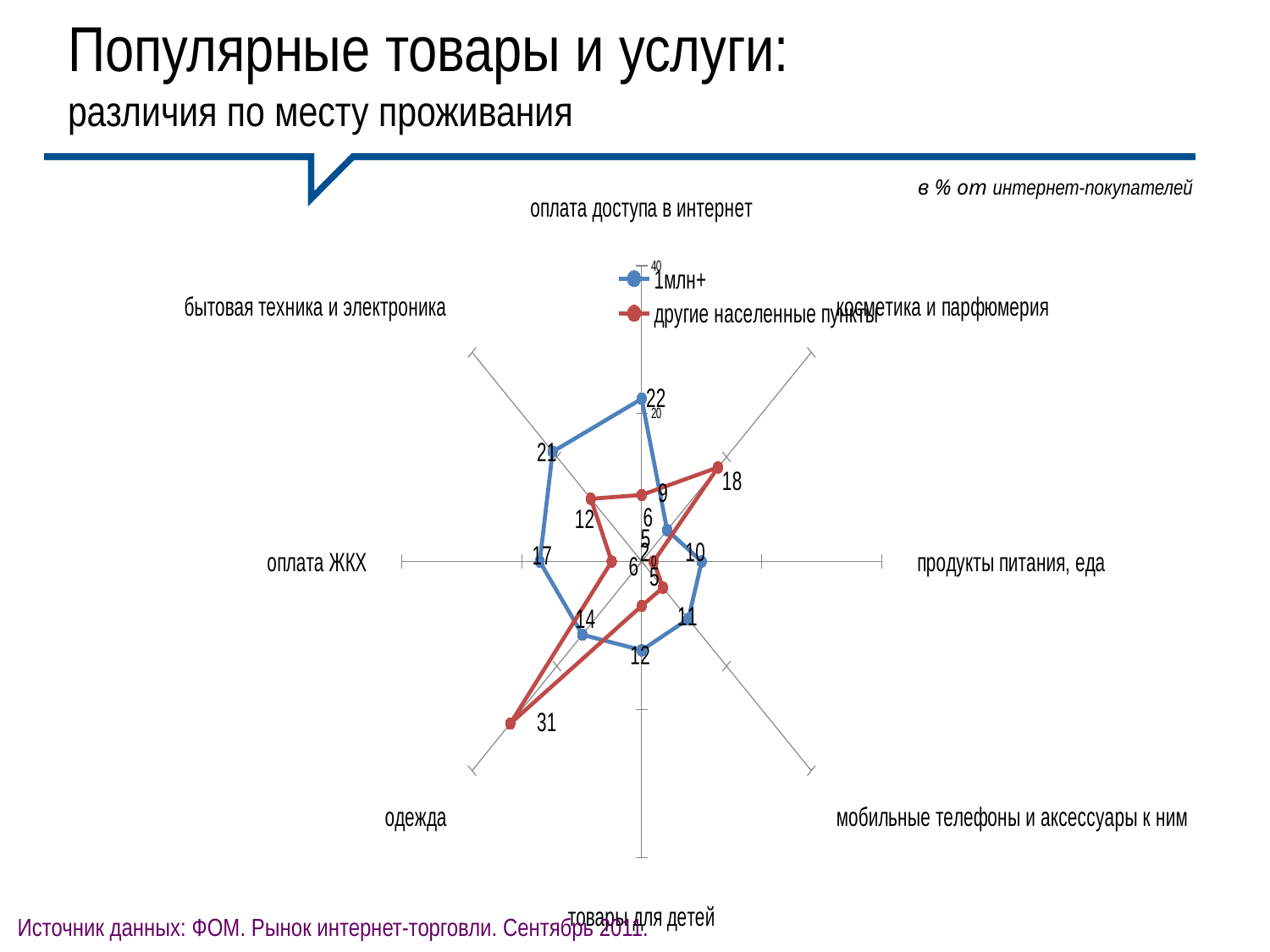
What is the value for 'косметика и парфюмерия' in the 'другие населенные пункты' series? 18 What is the difference between the 'другие населенные пункты' and '1млн+' values for 'одежда'? 17 What is the value for 'одежда' in the 'другие населенные пункты' series? 31 Which category has the highest value in the 'другие населенные пункты' series? одежда For 'бытовая техника и электроника', which series has the larger value? 1млн+ What is the value for 'одежда' in the '1млн+' series? 14 What are the two series names shown in the legend? 1млн+ and другие населенные пункты What is the value for 'оплата доступа в интернет' in the '1млн+' series? 22 How many series does the legend list? 2 How many categories (axes) does the radar chart have? 8 Which category has the highest value in the '1млн+' series? оплата доступа в интернет What kind of chart is shown on the slide? radar chart